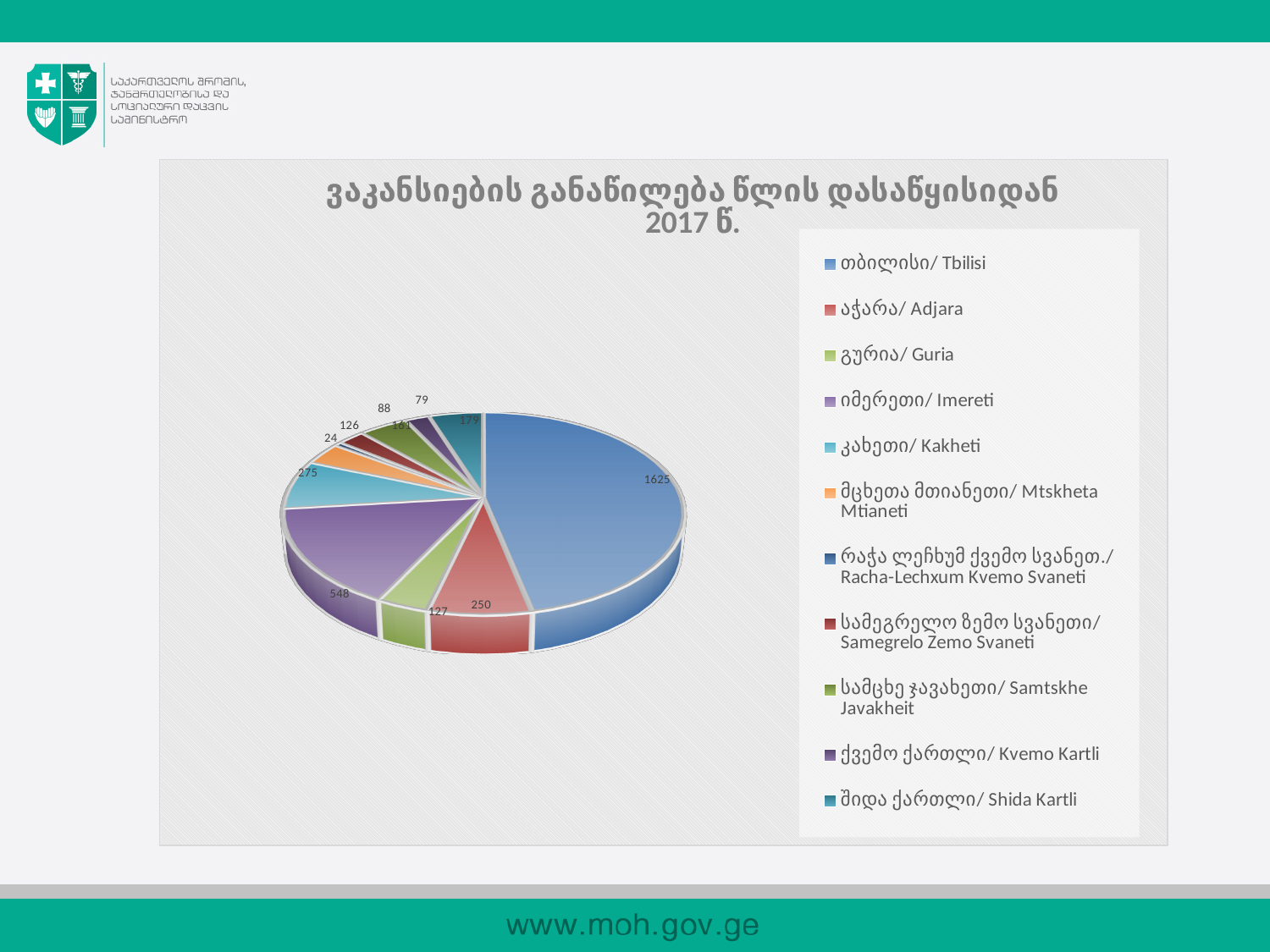
What type of chart is shown on the slide? pie chart What is the value for Mtskheta Mtianeti in the pie chart? 126 Which region has the smallest slice in the pie chart? Racha-Lechxum Kvemo Svaneti What is the difference between the values for Imereti and Kakheti? 273 Which year is shown in the chart title? 2017 How many categories (regions) does the pie chart show? 11 Which is larger, the value for Adjara or the value for Guria? Adjara What is the value for Kakheti in the pie chart? 275 Which region has the largest slice in the pie chart? Tbilisi What is the value for Adjara in the pie chart? 250 What is the value for Imereti in the pie chart? 548 What is the value for Tbilisi in the pie chart? 1625